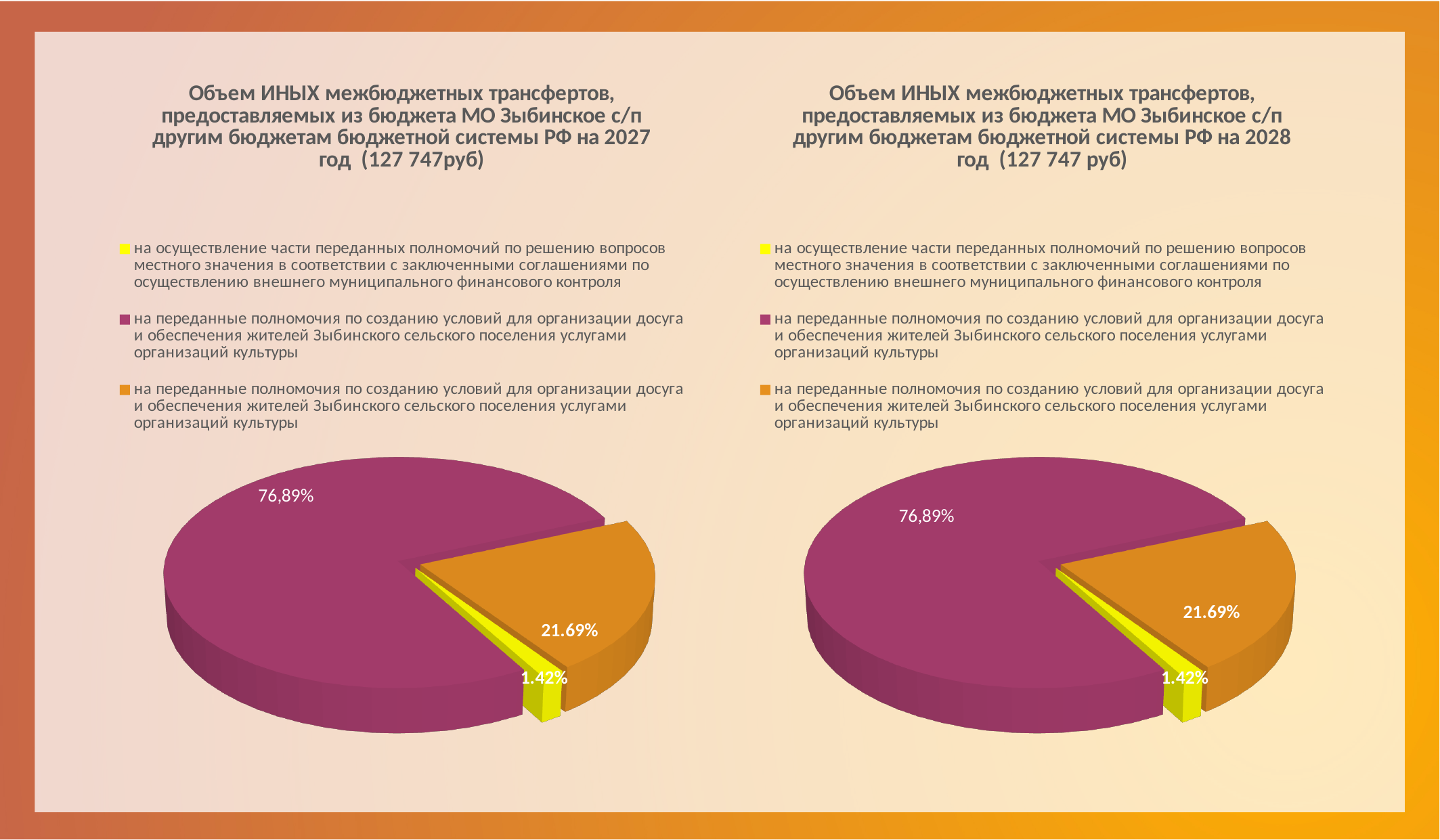
In the left chart (2027), which slice is the smallest? the yellow slice (1.42%) In the left chart (2027), which is larger: the orange slice or the yellow slice? the orange slice In the right chart (2028), what share is shown for the yellow slice (external municipal financial control)? 1.42% What total amount in rubles is given in the title of the right chart (2028)? 127 747 руб How many entries does the legend of the left chart (2027) list? 3 In the left chart (2027), what share is shown for the magenta slice? 76,89% In the right chart (2028), which slice is the largest? the magenta slice (76,89%) In the left chart (2027), what share is shown for the yellow slice (external municipal financial control)? 1.42% In the right chart (2028), what share is shown for the orange slice? 21.69% What kind of chart is the left chart (2027)? pie chart How many slices does the right chart (2028) have? 3 In the left chart (2027), what share is shown for the orange slice? 21.69%